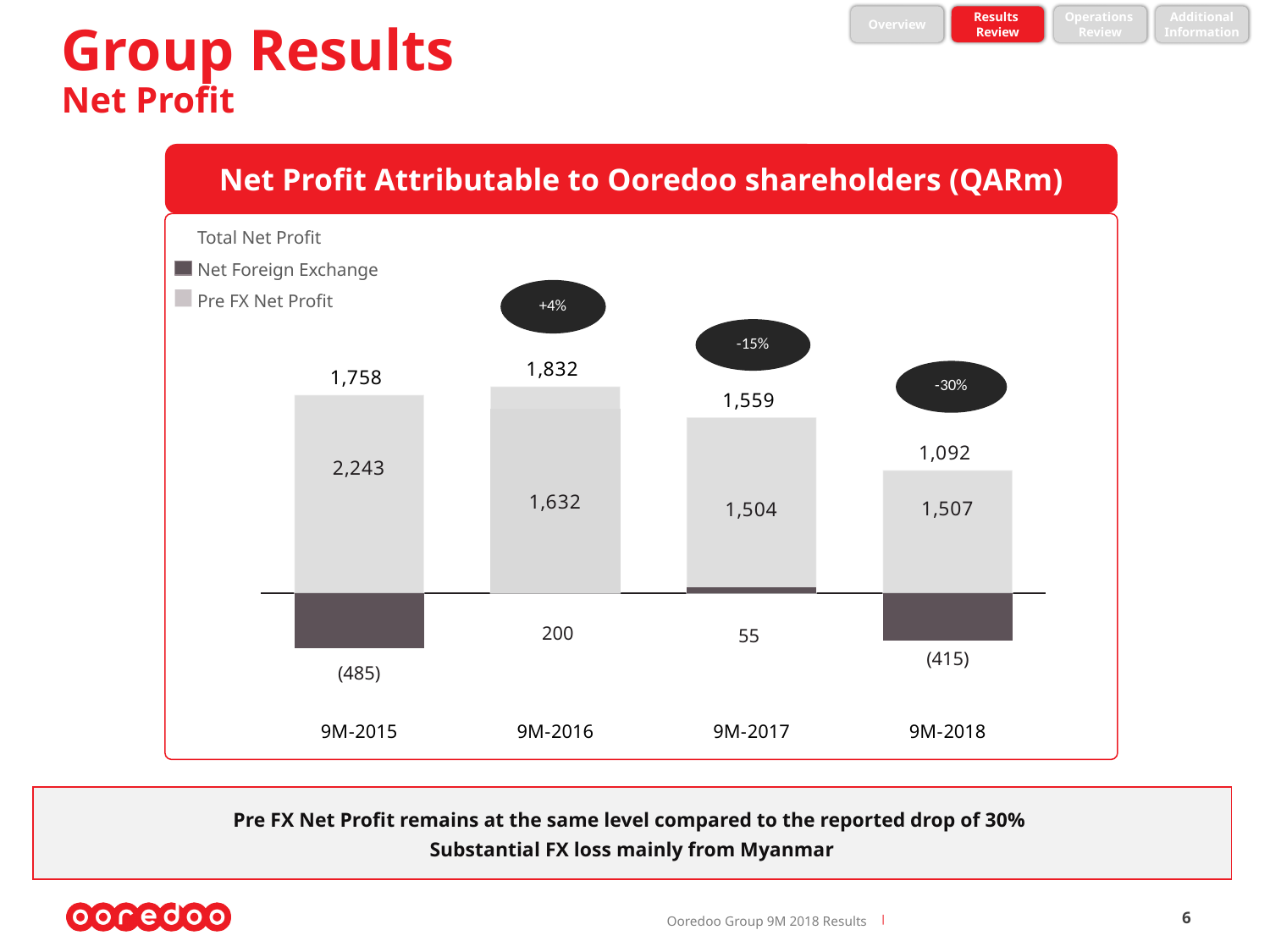
Which is larger, the Pre FX Net Profit for 9M-2016 or for 9M-2017? 9M-2016 How many periods are shown on the x axis of the chart? 4 What is the Total Net Profit for 9M-2018? 1,092 Which period has the highest Total Net Profit? 9M-2016 What percentage change is shown above the 9M-2017 bar? -15% What is the difference between the Total Net Profit for 9M-2017 and 9M-2018? 467 What is the Net Foreign Exchange value for 9M-2016? 200 How many series does the legend list? 3 What is the Net Foreign Exchange value for 9M-2018? (415) Which period has the lowest Total Net Profit? 9M-2018 What kind of chart is shown on the slide? Stacked bar chart What is the Pre FX Net Profit for 9M-2015? 2,243